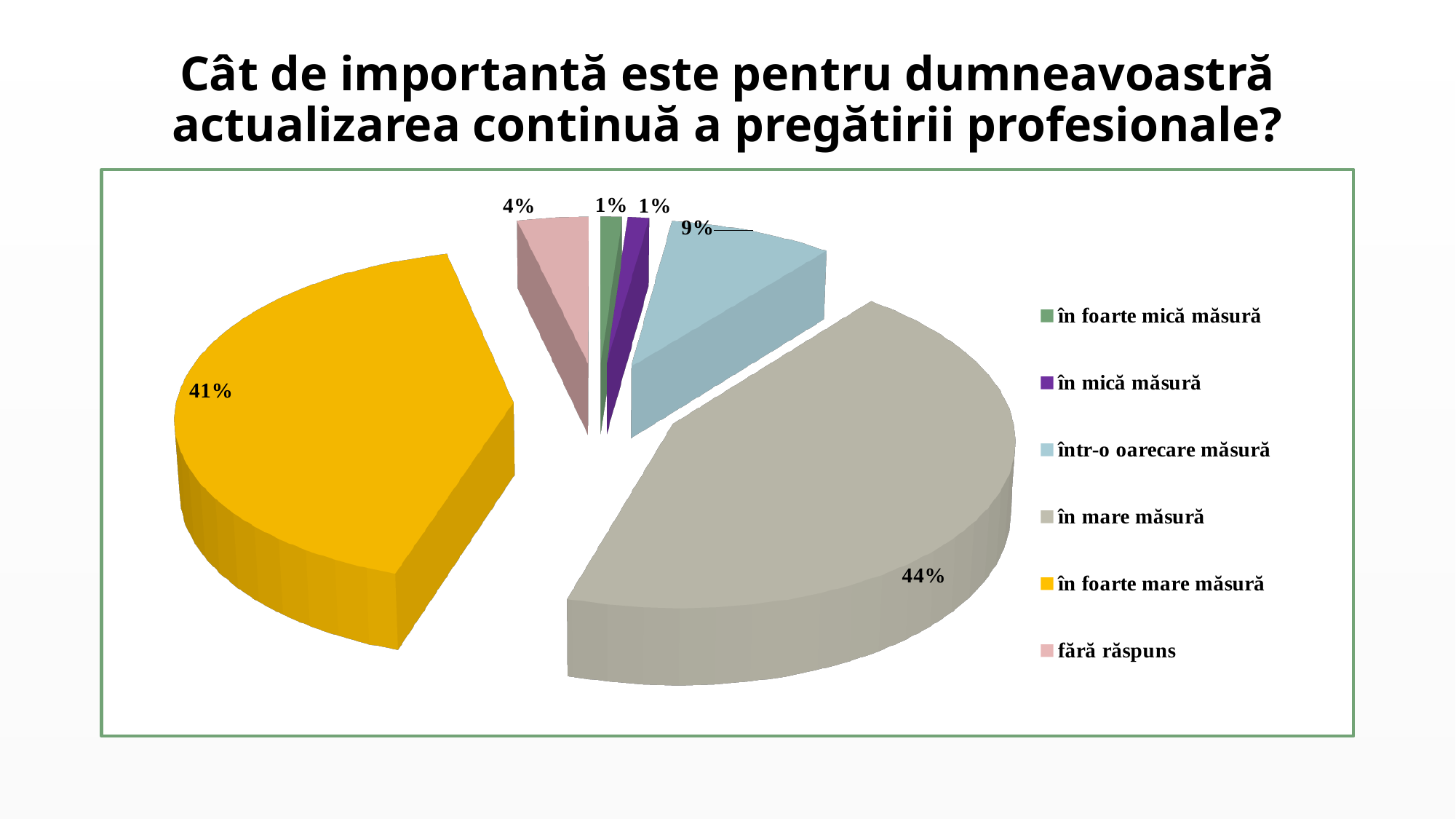
Which is larger, the slice for "în mare măsură" or the slice for "în foarte mare măsură"? în mare măsură What share of the pie does "în foarte mare măsură" represent? 41% What is the difference between the values for "într-o oarecare măsură" and "fără răspuns"? 5% What share of the pie does "în mare măsură" represent? 44% What is the difference between the values for "în mare măsură" and "în foarte mare măsură"? 3% What colour is the slice for "în foarte mare măsură"? yellow What is the value for "fără răspuns"? 4% Which category has the largest slice of the pie? în mare măsură What is the value for "în mică măsură"? 1% What kind of chart is shown on the slide? pie chart What is the value for "într-o oarecare măsură"? 9% How many categories does the legend list? 6